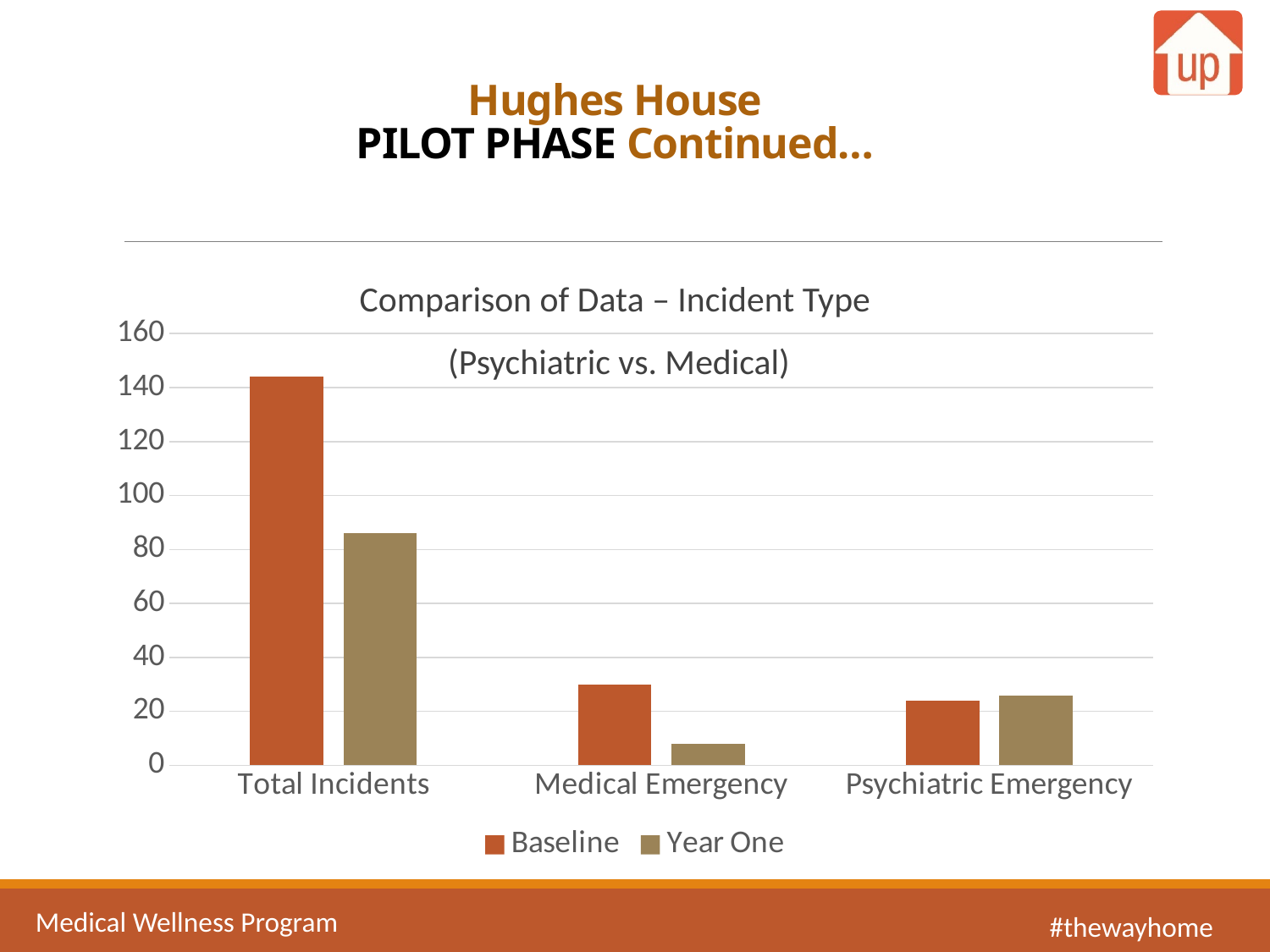
For Total Incidents, which is larger: the Baseline value or the Year One value? Baseline Is the Year One value for Total Incidents greater or less than 100? less Is the Baseline value for Medical Emergency greater or less than 20? greater Which category has the highest Baseline value? Total Incidents How many series does the legend list? 2 What is the title of the chart? Comparison of Data – Incident Type (Psychiatric vs. Medical) What kind of chart is shown on the slide? Bar chart How many categories are shown on the x axis? 3 Which series is shown in the orange-red colour in the legend? Baseline Is the Baseline value for Total Incidents greater or less than 140? greater Which category has the lowest Year One value? Medical Emergency